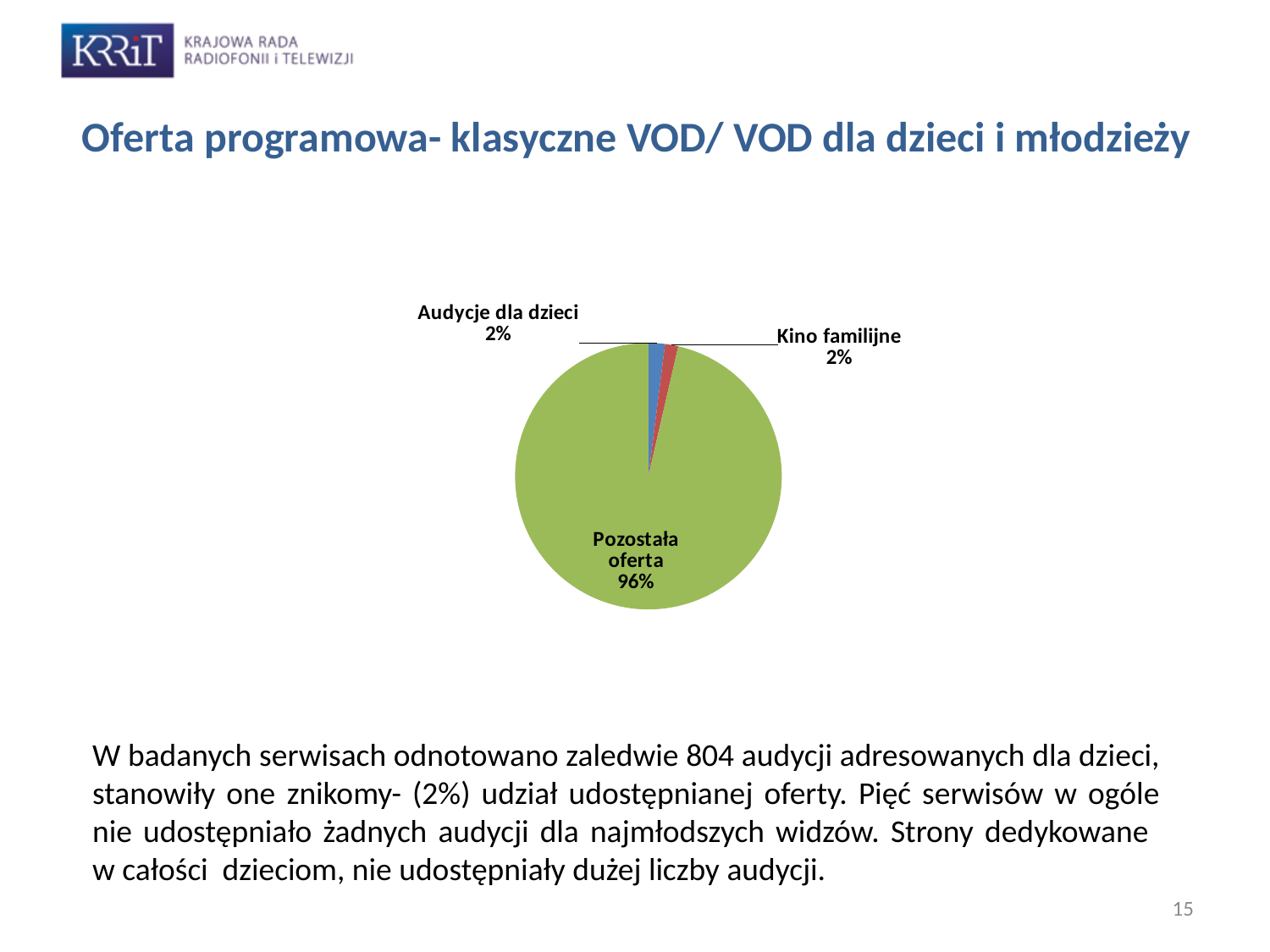
What share of the pie does Kino familijne represent? 2% What is the difference in percentage points between the Pozostała oferta slice and the Audycje dla dzieci slice? 94 percentage points What share of the pie does Pozostała oferta represent? 96% How many slices does the pie chart have? 3 What is the combined share of the Audycje dla dzieci and Kino familijne slices? 4% Which is larger, the share for Pozostała oferta or the share for Kino familijne? Pozostała oferta What share of the pie does Audycje dla dzieci represent? 2% What colour is the Audycje dla dzieci slice? Blue What colour is the Pozostała oferta slice? Green Which slice of the pie chart is the largest? Pozostała oferta What kind of chart is shown on the slide? Pie chart